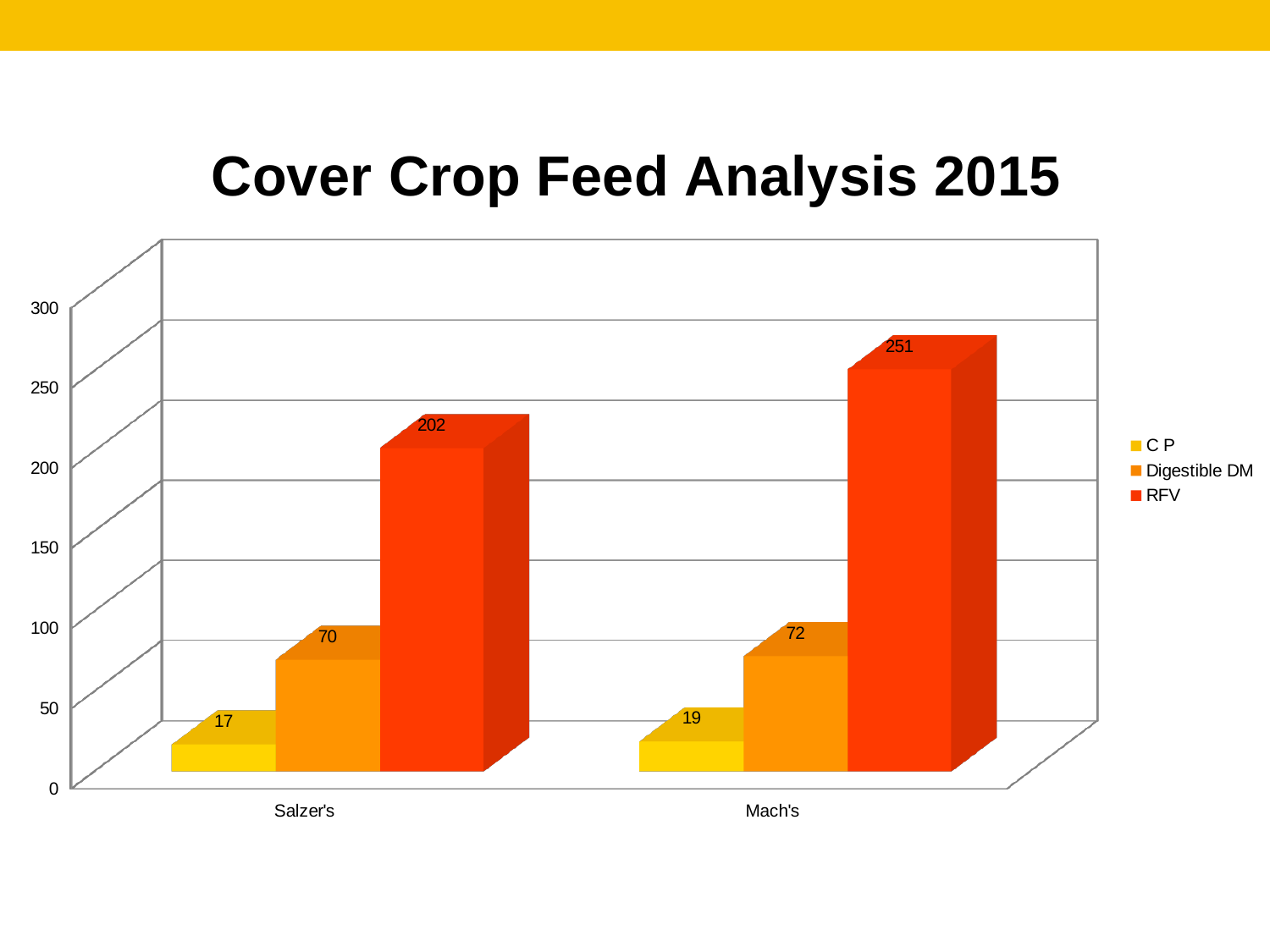
What is the C P value for Mach's? 19 What kind of chart is shown on the slide? bar chart How many series does the legend list? 3 What is the difference between the Digestible DM values for Mach's and Salzer's? 2 Which series has the lowest value for Mach's? C P How many categories are shown on the x axis? 2 Which category has the higher RFV value? Mach's Is the RFV value for Mach's greater or less than 250? greater What is the RFV value for Salzer's? 202 What is the Digestible DM value for Salzer's? 70 Is the C P value for Salzer's larger or smaller than the C P value for Mach's? smaller What is the difference between the RFV values for Mach's and Salzer's? 49